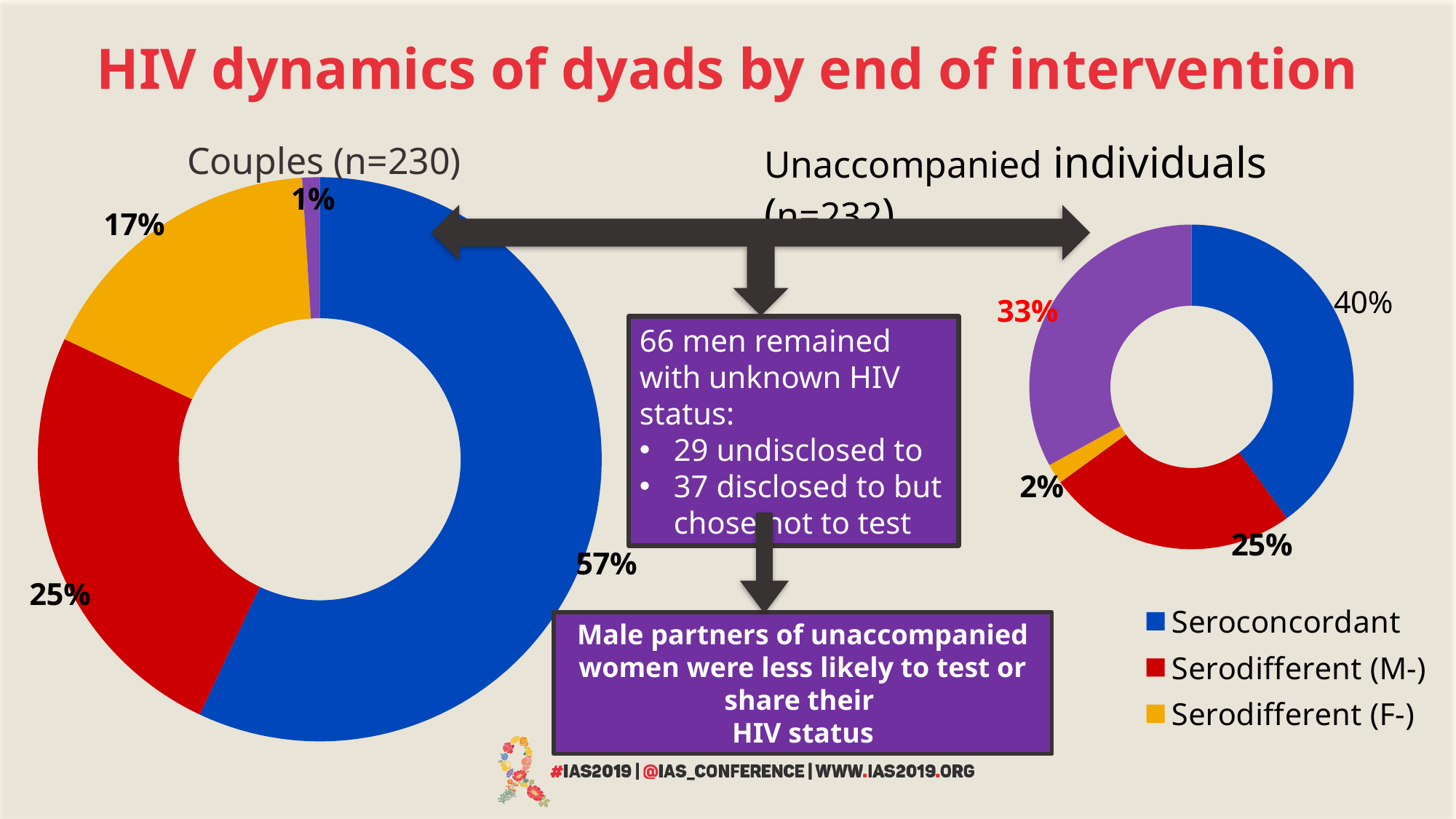
In the Couples (n=230) chart, what share is Serodifferent (F-)? 17% In the Couples (n=230) chart, what share is Seroconcordant? 57% In the Couples (n=230) chart, which category has the largest share? Seroconcordant How many entries does the legend list? 3 In the Unaccompanied individuals (n=232) chart, which category has the smallest share? Serodifferent (F-) What type of chart is used for the Couples (n=230) data? Doughnut chart Which chart has the larger Serodifferent (F-) share, Couples (n=230) or Unaccompanied individuals (n=232)? Couples (n=230) In the Unaccompanied individuals (n=232) chart, what share is Seroconcordant? 40% In the Unaccompanied individuals (n=232) chart, what share is Serodifferent (F-)? 2% In the Unaccompanied individuals (n=232) chart, what share does the purple slice represent? 33% What colour represents Serodifferent (M-) in the charts? Red What is the difference between the Seroconcordant share in the Couples (n=230) chart and in the Unaccompanied individuals (n=232) chart? 17 percentage points